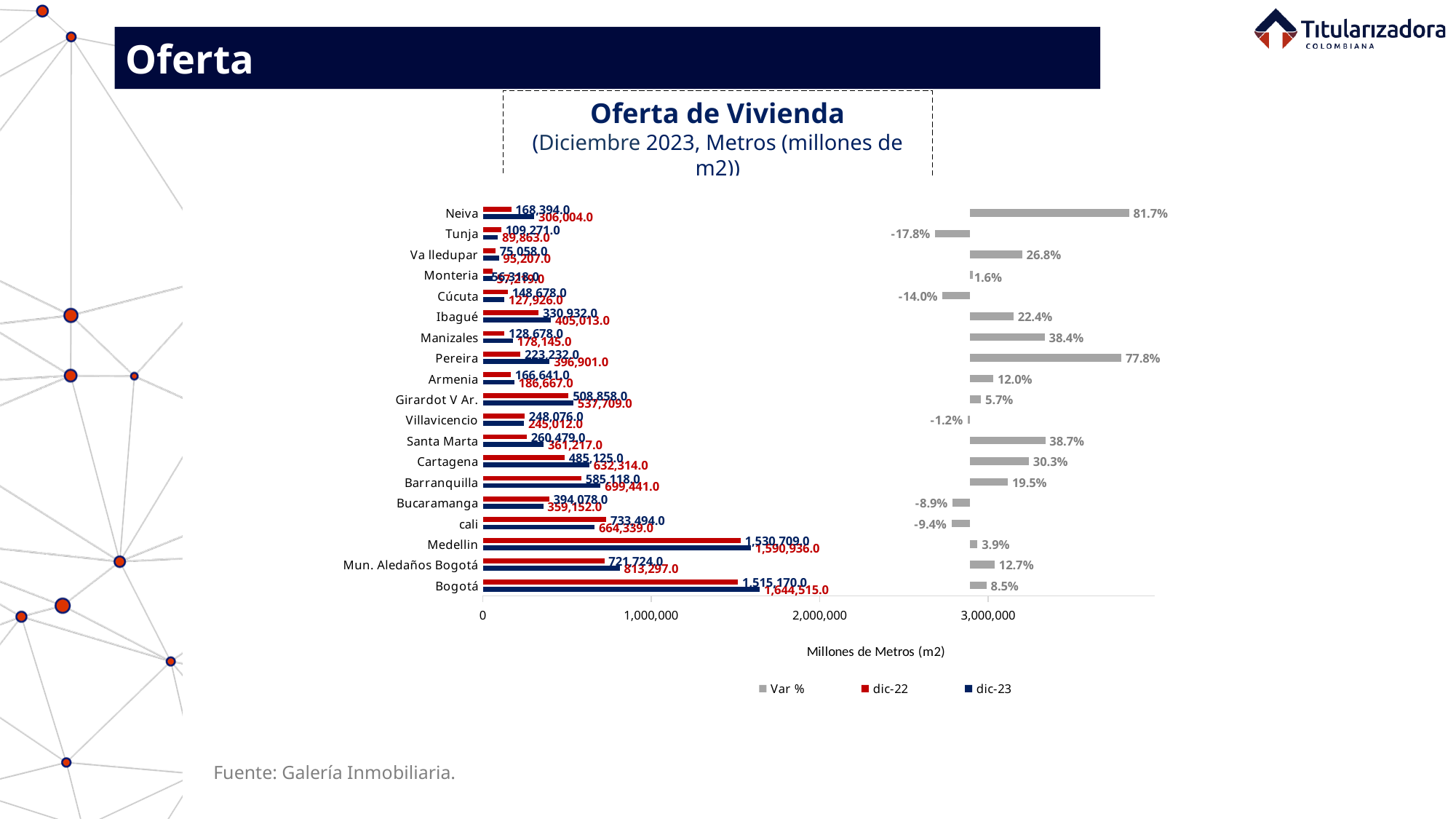
Which is larger, the Var % for Santa Marta or the Var % for Manizales? Santa Marta Is the dic-23 value for cali greater or less than 1,000,000? less Which city has the lowest Var % value? Tunja Which city has the highest Var % value? Neiva How many series does the legend list? 3 What is the Var % value for Pereira? 77.8% What is the dic-22 value for Medellin? 1,530,709.0 How many cities are listed on the chart? 19 What is the difference between the dic-23 and dic-22 values for Bogotá? 129,345.0 What is the Var % value for Cúcuta? -14.0% What kind of chart is shown on the slide? bar chart What is the dic-23 value for Bogotá? 1,644,515.0